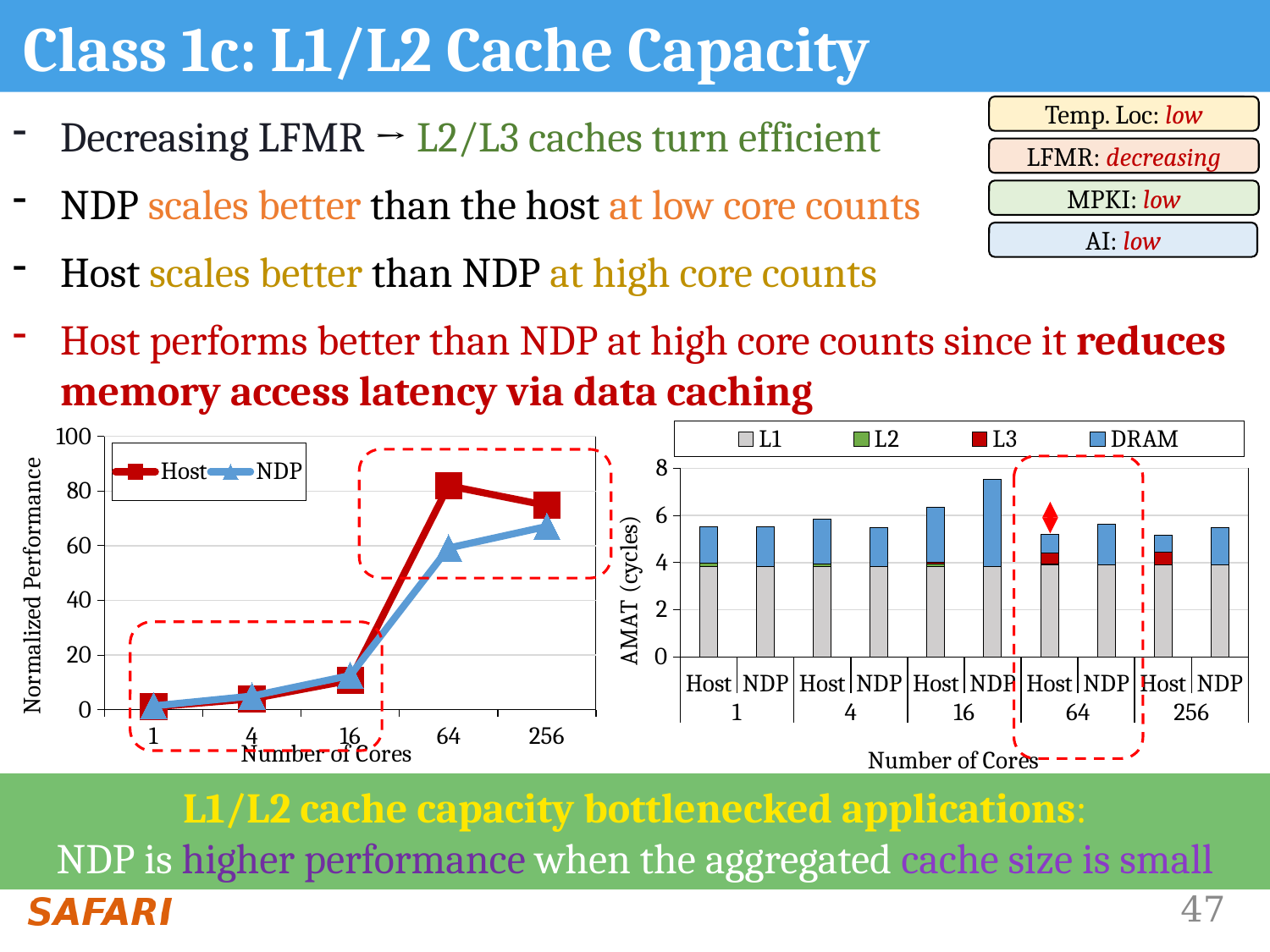
In the right chart, what are the four legend entries? L1, L2, L3, DRAM In the left chart, how many series does the legend list? 2 In the left chart, is the NDP normalized performance at 16 cores greater or less than 20? less In the left chart, which series has the higher normalized performance at 64 cores, Host or NDP? Host In the right chart, is the AMAT for NDP at 16 cores greater or less than 6? greater In the right chart, how many series does the legend list? 4 What kind of chart is the right chart (AMAT vs Number of Cores)? bar chart What kind of chart is the left chart (Normalized Performance vs Number of Cores)? line chart In the left chart, how many core-count values are shown on the x axis? 5 In the right chart, which bar has the highest AMAT? NDP at 16 cores In the left chart, is the Host normalized performance at 64 cores greater or less than 60? greater In the left chart, does the Host normalized performance rise or fall from 1 core to 64 cores? rise